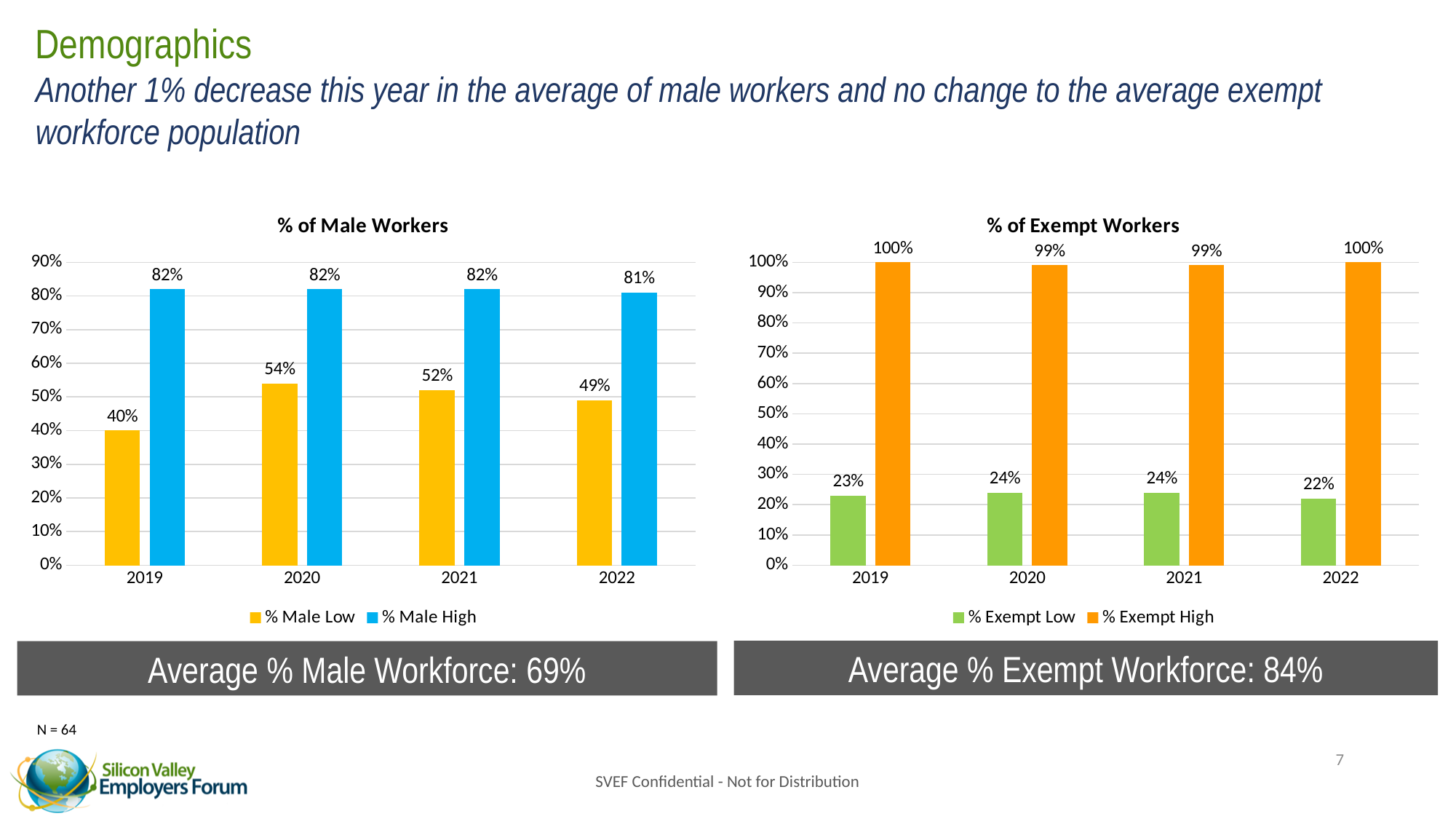
In the '% of Male Workers' chart, which year has the lowest % Male Low value? 2019 What type of chart is the '% of Male Workers' chart? bar chart In the '% of Male Workers' chart, which year has the highest % Male Low value? 2020 How many series does the legend of the '% of Exempt Workers' chart list? 2 In the '% of Exempt Workers' chart, what is the % Exempt High value for 2020? 99% In the '% of Male Workers' chart, does the % Male Low value rise or fall from 2020 to 2022? fall In the '% of Exempt Workers' chart, what is the difference between % Exempt High and % Exempt Low in 2019? 77% In the '% of Male Workers' chart, what is the difference between % Male High and % Male Low in 2021? 30% In the '% of Exempt Workers' chart, which year has the lowest % Exempt Low value? 2022 In the '% of Exempt Workers' chart, what is the % Exempt Low value for 2022? 22% In the '% of Male Workers' chart, what is the % Male High value for 2022? 81% In the '% of Male Workers' chart, what is the % Male Low value for 2019? 40%